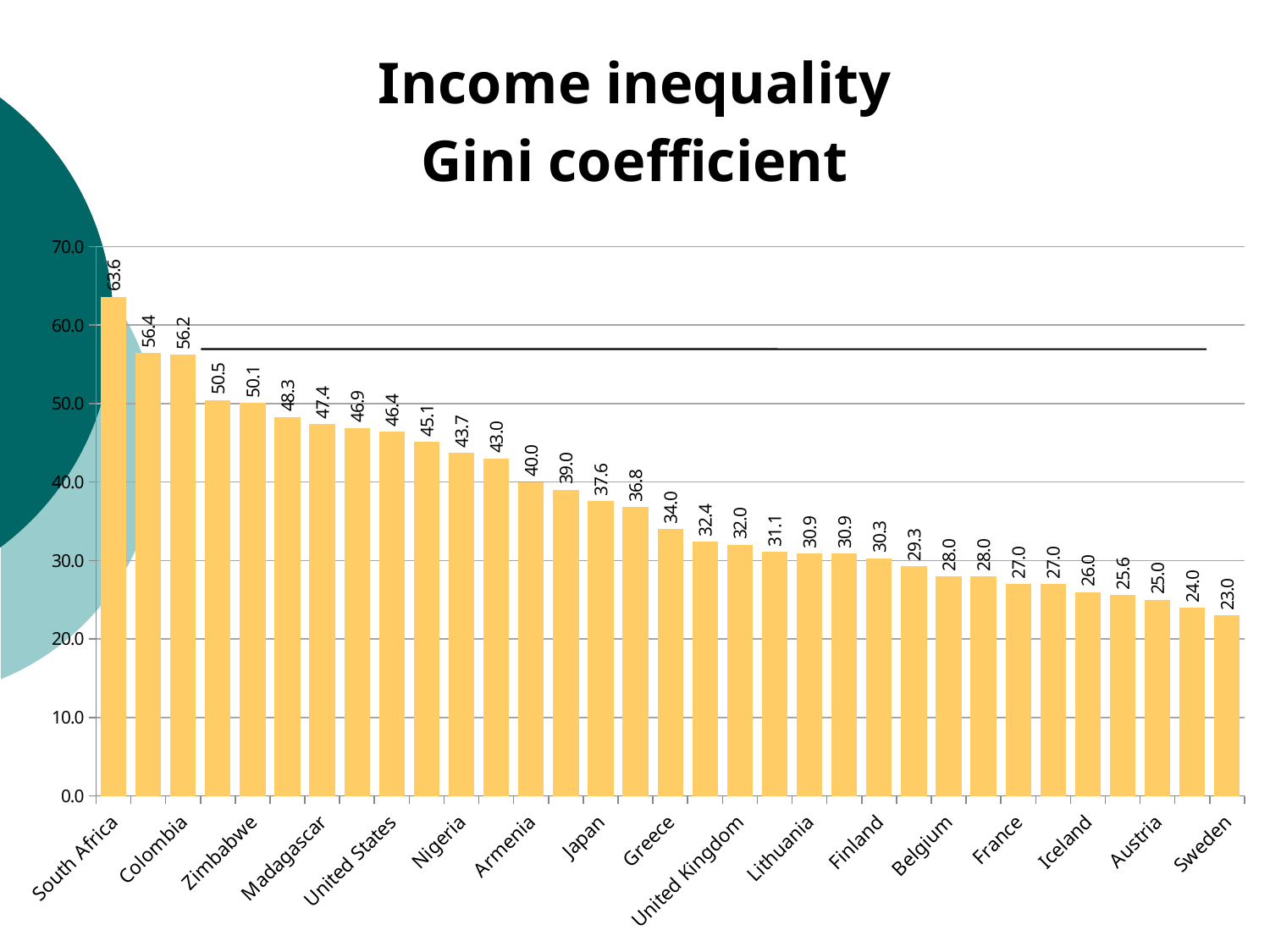
Do the values rise or fall from left to right along the x axis? fall Is the value for Nigeria greater or less than 40.0? greater What type of chart is shown on the slide? bar chart Which country has the highest Gini coefficient on the chart? South Africa How many bars are plotted on the chart? 33 What is the difference between the Gini coefficients of South Africa and Sweden? 40.6 What is the Gini coefficient shown for South Africa? 63.6 Which has a higher Gini coefficient, Japan or Greece? Japan What is the Gini coefficient shown for the United States? 46.4 Which country has the lowest Gini coefficient on the chart? Sweden What is the Gini coefficient shown for Sweden? 23.0 What is the Gini coefficient shown for Japan? 37.6